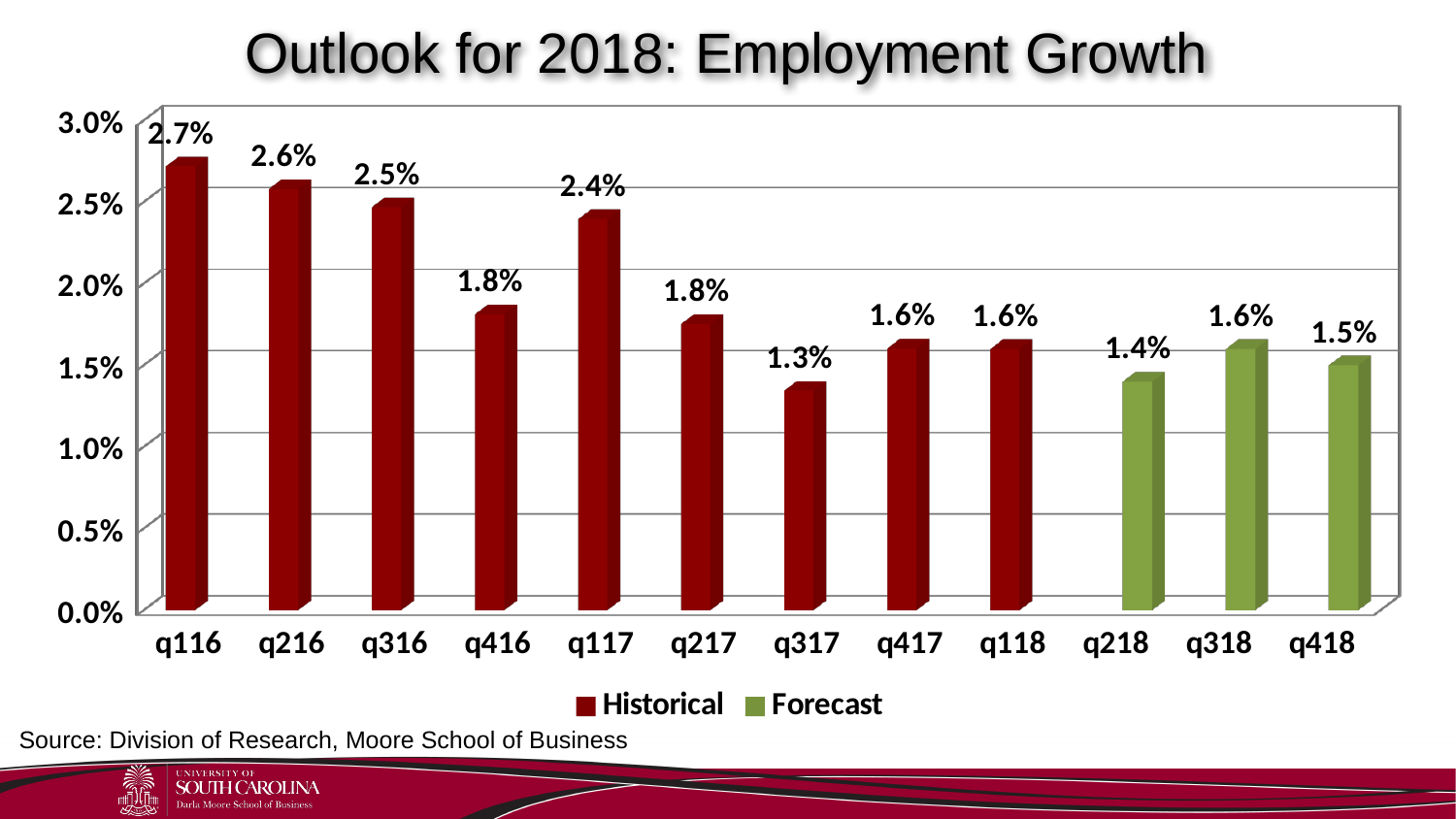
What is the employment growth value for q317? 1.3% What is the difference between the employment growth for q116 and q317? 1.4% Which quarter has the highest employment growth? q116 What is the employment growth value for q116? 2.7% Which series is shown in green? Forecast Which quarter has the lowest employment growth? q317 Which is larger, the employment growth for q316 or q416? q316 What is the difference between the employment growth for q117 and q217? 0.6% What kind of chart is shown on the slide? bar chart How many quarters are shown on the x axis? 12 How many series does the legend list? 2 What is the forecast employment growth for q418? 1.5%